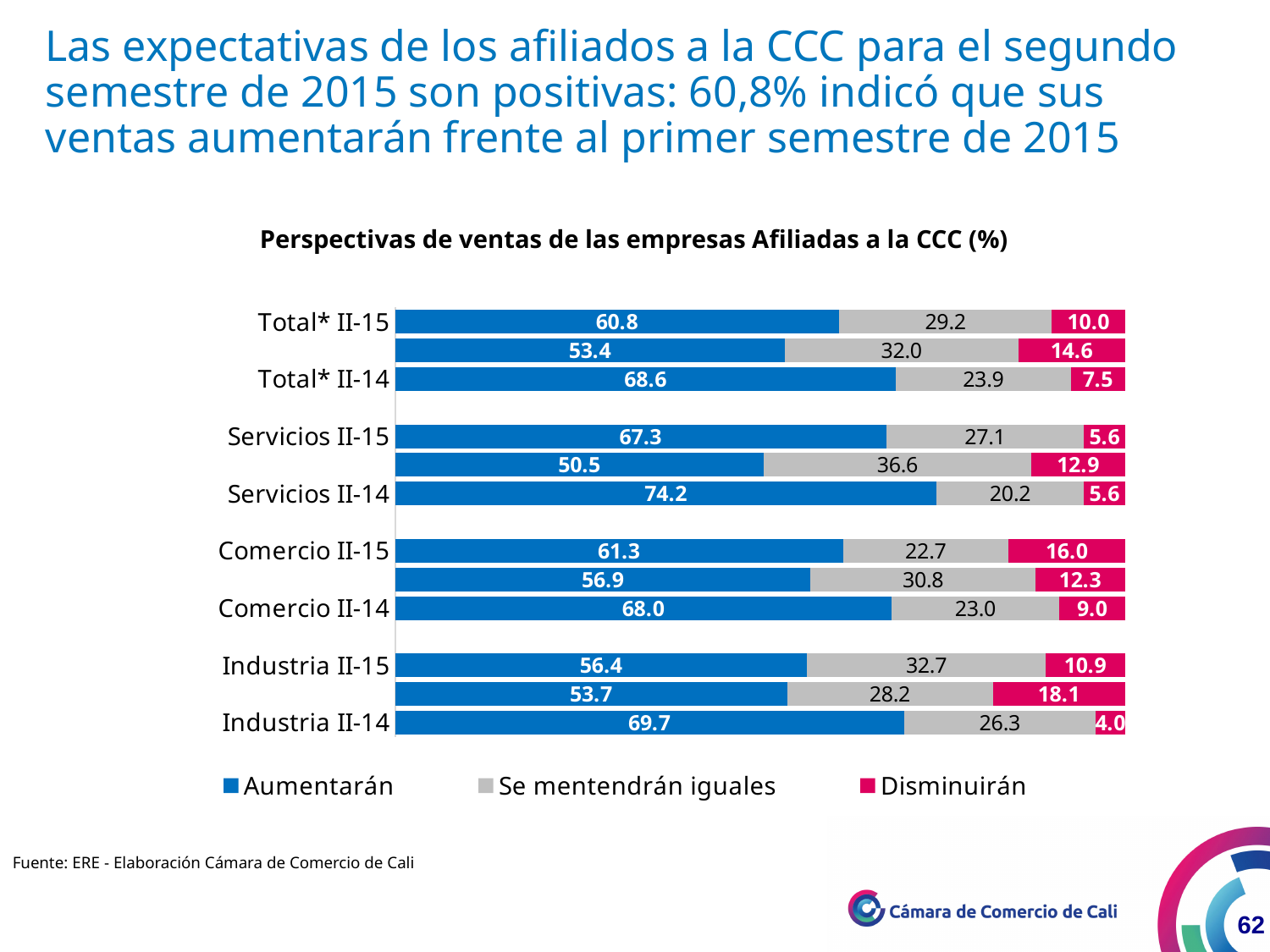
Among the labeled categories, which has the highest 'Aumentarán' value? Servicios II-14 What is the total of the stacked bar for Comercio II-14? 100.0 What is the 'Se mentendrán iguales' value for Industria II-15? 32.7 Among the labeled categories, which has the lowest 'Disminuirán' value? Industria II-14 What is the 'Aumentarán' value for Servicios II-14? 74.2 Which is larger, the 'Disminuirán' value for Industria II-15 or for Comercio II-15? Comercio II-15 How many series does the legend list? 3 What is the 'Disminuirán' value for Comercio II-15? 16.0 What is the title of the chart? Perspectivas de ventas de las empresas Afiliadas a la CCC (%) What is the 'Aumentarán' value for Total* II-15? 60.8 What is the difference between the 'Aumentarán' values for Total* II-14 and Total* II-15? 7.8 What kind of chart is shown on the slide? stacked bar chart